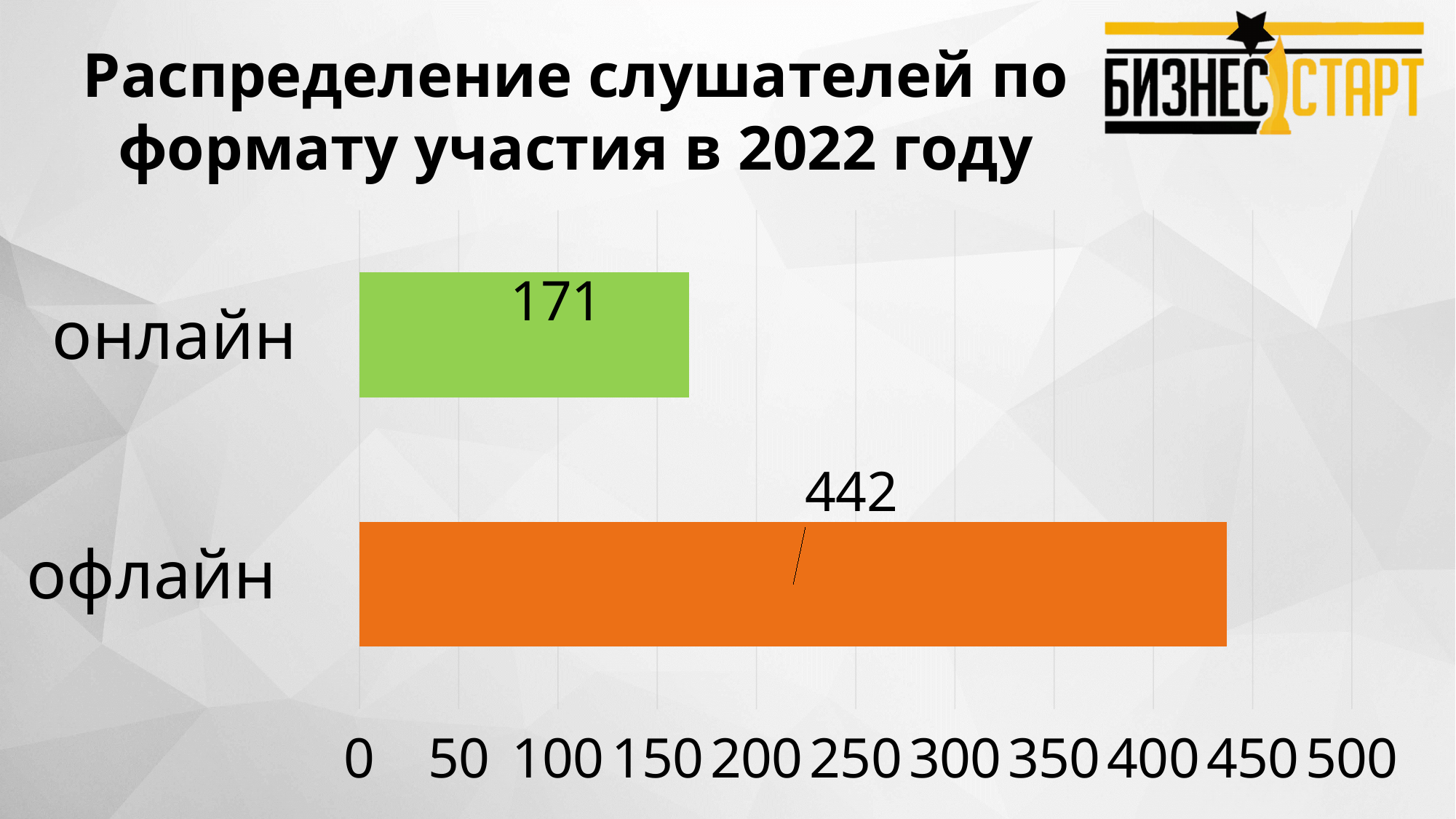
What colour is the bar for офлайн? orange What is the value for онлайн? 171 What is the title of the chart? Распределение слушателей по формату участия в 2022 году Which is larger, the value for онлайн or the value for офлайн? офлайн What kind of chart is shown on the slide? bar chart Is the value for офлайн greater or less than 400? greater Which category has the lowest value? онлайн Which category has the highest value? офлайн Is the value for онлайн greater or less than 200? less What is the difference between the values for офлайн and онлайн? 271 How many categories are shown in the chart? 2 What is the value for офлайн? 442